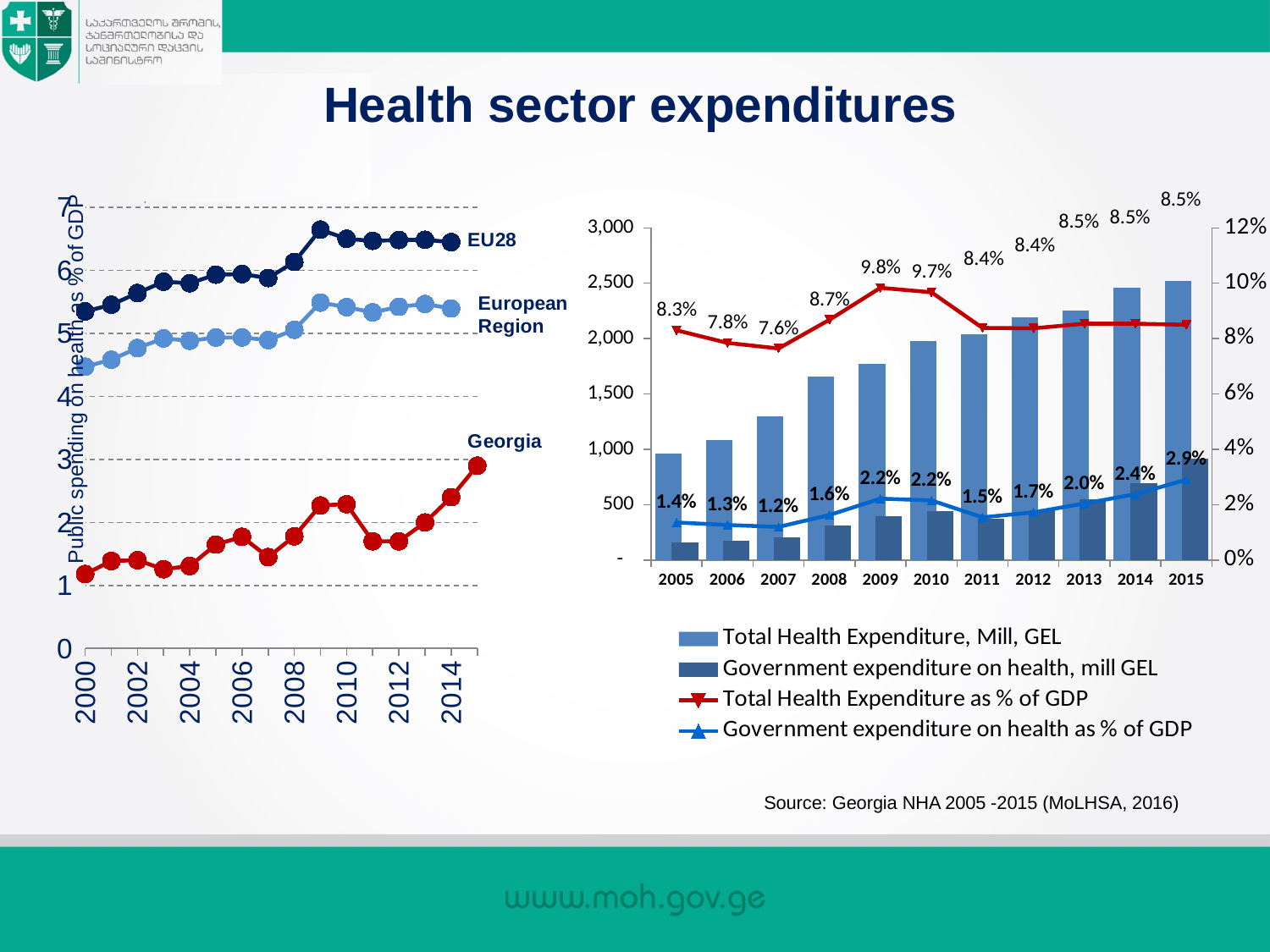
How many years are shown on the x axis of the right-hand chart? 11 In the right-hand chart, by how many percentage points did Total Health Expenditure as % of GDP in 2009 exceed that in 2007? 2.2 percentage points In the right-hand chart, by how many percentage points did Government expenditure on health as % of GDP rise from 2005 to 2015? 1.5 percentage points How many series does the legend of the right-hand chart list? 4 What kind of chart is the left-hand chart showing public spending on health as % of GDP? Line chart In the right-hand chart, which year had the lowest Government expenditure on health as % of GDP? 2007 In the right-hand chart, which year had the higher Government expenditure on health as % of GDP, 2013 or 2014? 2014 In the right-hand chart, what was Government expenditure on health as % of GDP in 2015? 2.9% In the right-hand chart, what was Total Health Expenditure as % of GDP in 2009? 9.8% In the left-hand chart, which series has the lowest public spending on health as % of GDP throughout the period? Georgia In the right-hand chart, which year had the highest Total Health Expenditure as % of GDP? 2009